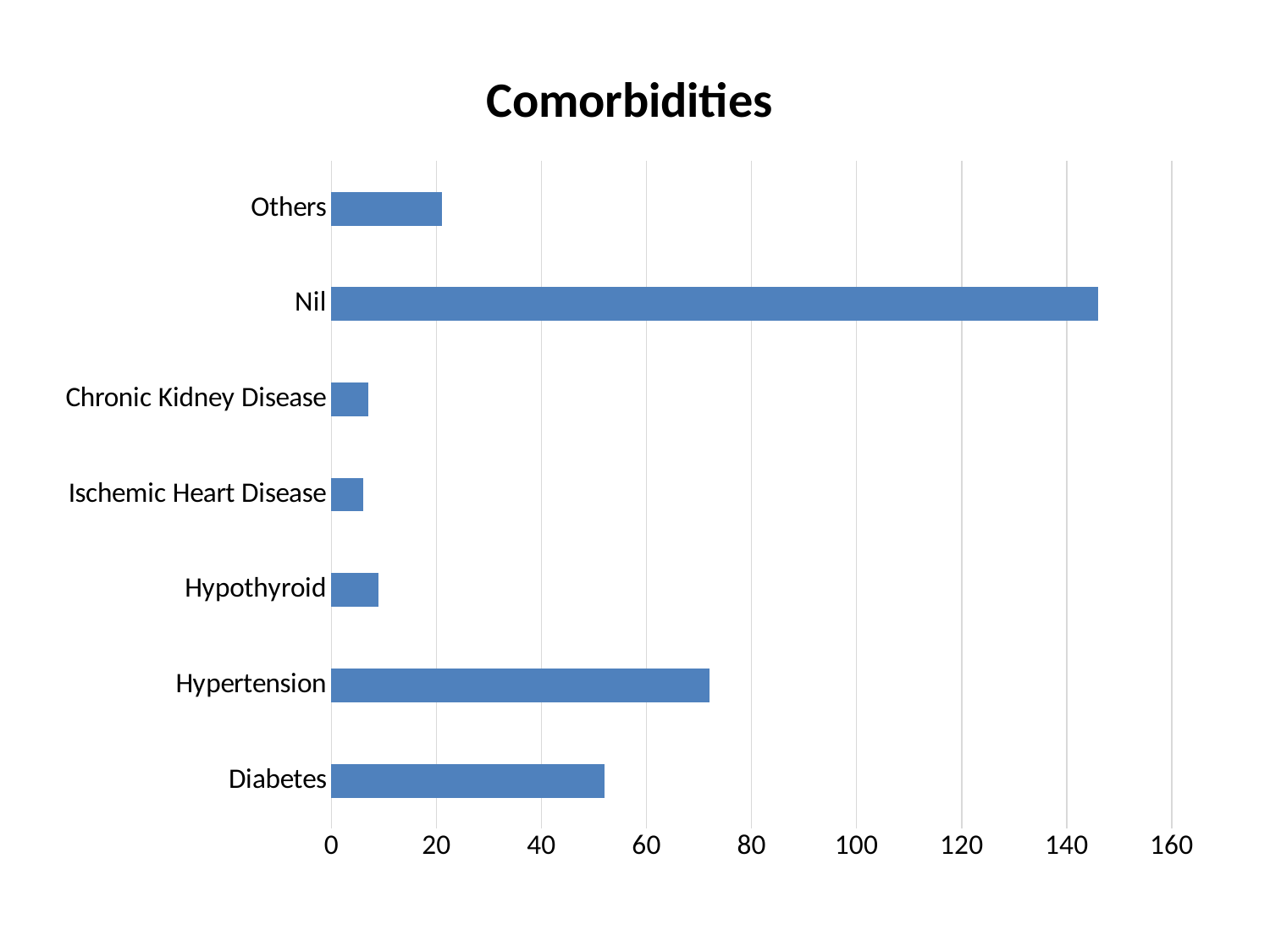
What is the title of the chart? Comorbidities Is the value for Hypertension greater or less than 60? greater Which is larger, the value for Hypertension or the value for Diabetes? Hypertension What kind of chart is shown on the slide? bar chart Is the value for Diabetes greater or less than 40? greater Is the value for Diabetes greater or less than 60? less Which is larger, the value for Others or the value for Chronic Kidney Disease? Others How many categories are plotted in the chart? 7 Which category has the highest value? Nil